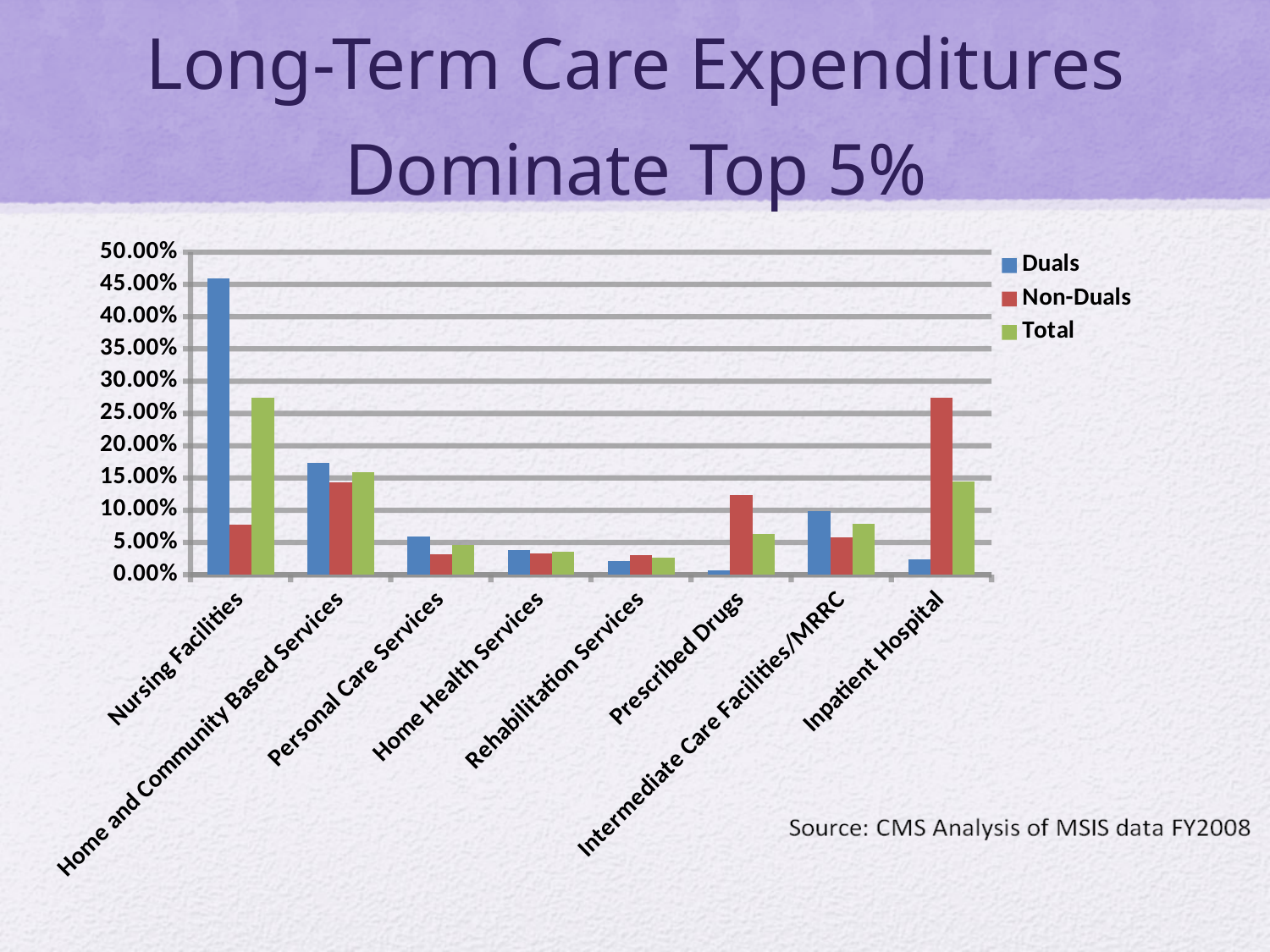
Which category has the lowest value for the Duals series? Prescribed Drugs How many series does the legend list? 3 Which category has the highest value for the Duals series? Nursing Facilities For Inpatient Hospital, which is larger: the Duals value or the Non-Duals value? Non-Duals Is the Duals value for Nursing Facilities greater or less than 40.00%? greater What kind of chart is shown on the slide? Bar chart Is the Non-Duals value for Inpatient Hospital greater or less than 25.00%? greater For Nursing Facilities, which is larger: the Duals value or the Non-Duals value? Duals What colour represents the Total series in the legend? Green How many service categories are shown on the x axis? 8 Which category has the highest value for the Non-Duals series? Inpatient Hospital Is the Total value for Nursing Facilities greater or less than 30.00%? less